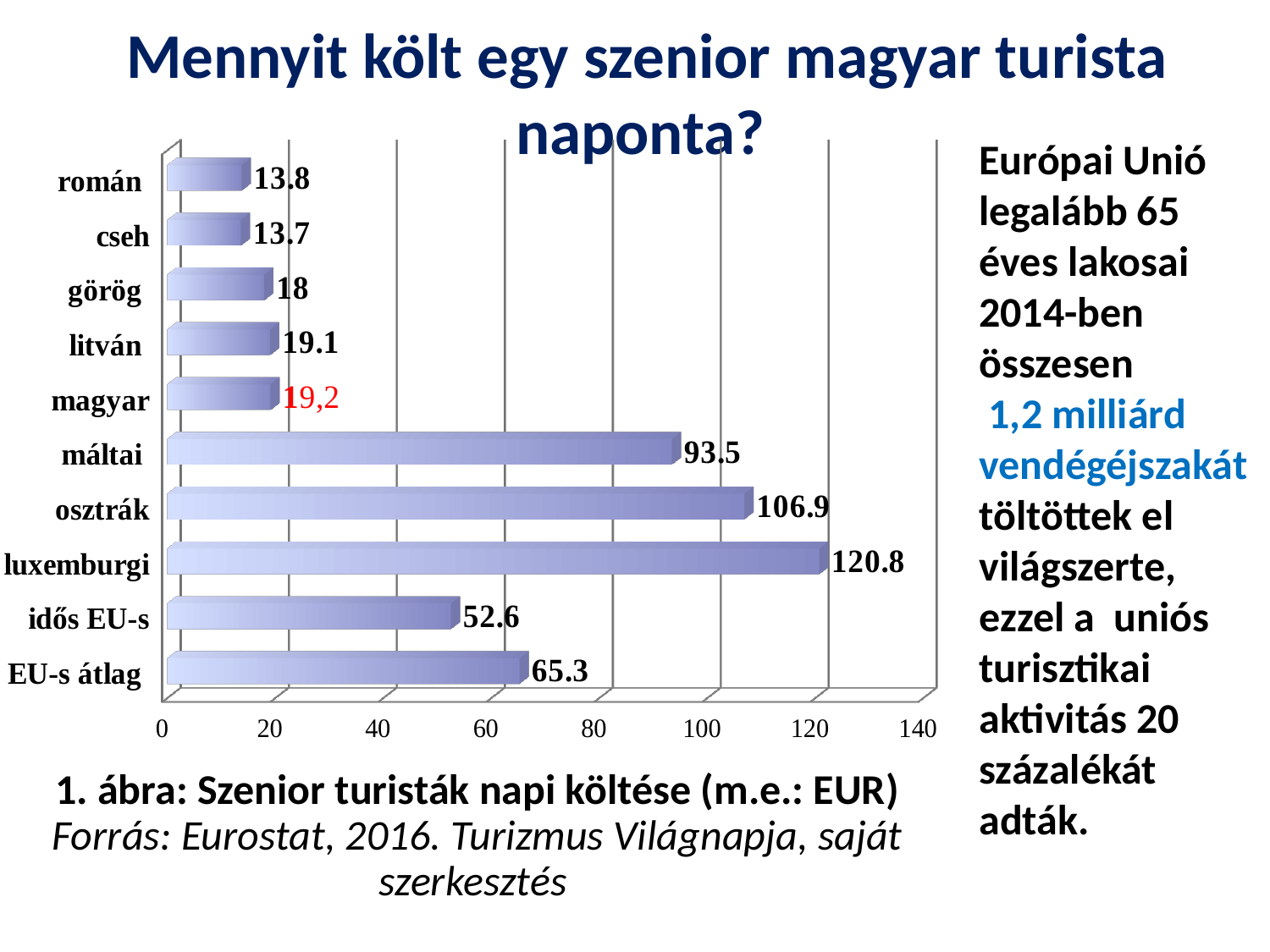
What is the difference between the values for EU-s átlag and idős EU-s? 12.7 Which category has the highest value? luxemburgi Which is larger, the value for máltai or the value for osztrák? osztrák What is the value for EU-s átlag? 65.3 What kind of chart is shown on the slide? bar chart Which category has the lowest value? cseh What is the value for magyar? 19,2 What is the value for luxemburgi? 120.8 What is the value for osztrák? 106.9 What is the difference between the values for luxemburgi and osztrák? 13.9 Is the value for máltai greater or less than 80? greater How many categories are shown in the chart? 10